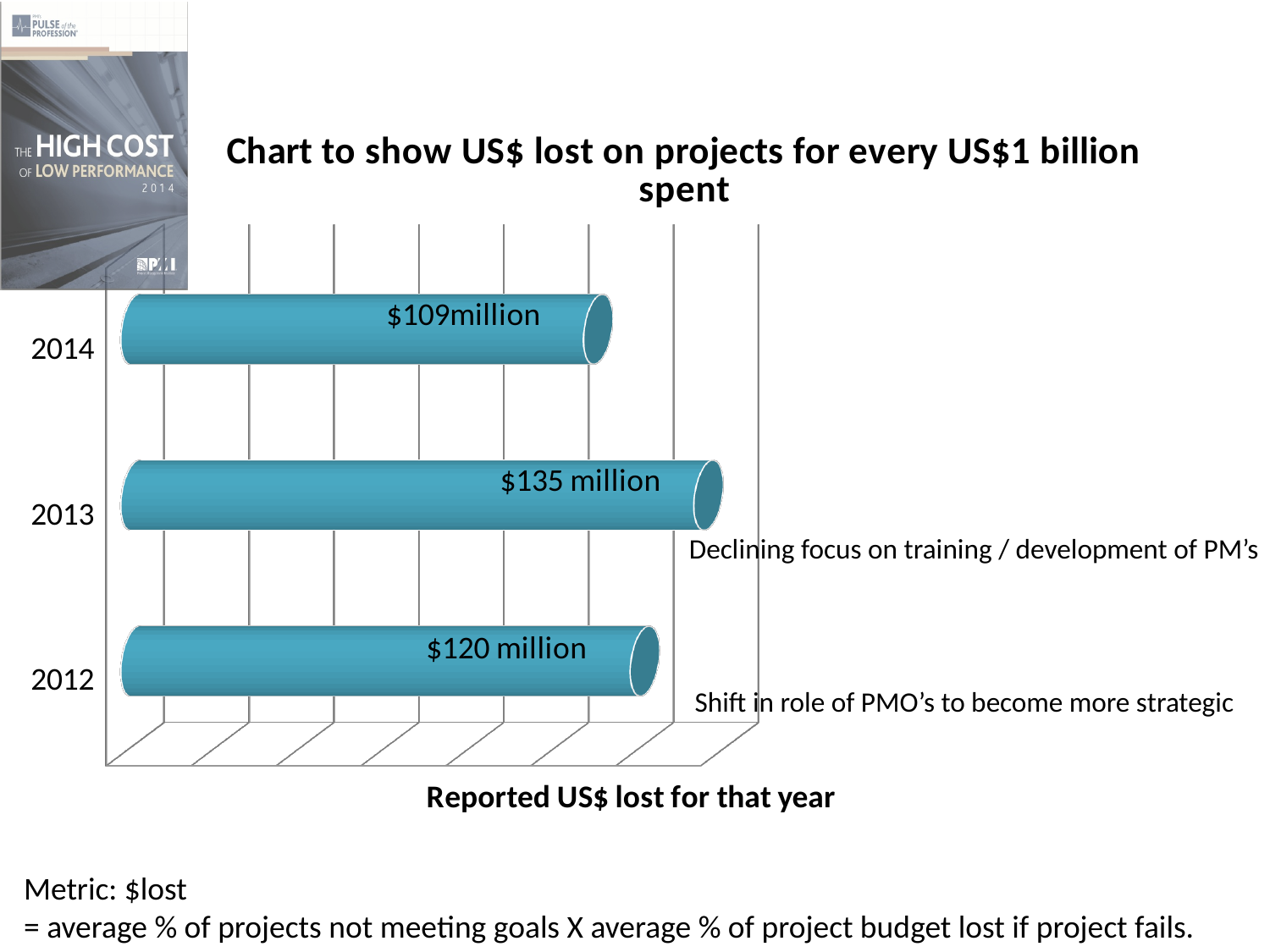
Which year has the lowest US$ lost? 2014 What is the value shown for 2014? $109million What kind of chart is shown on the slide? Bar chart What is the label shown below the chart's horizontal axis? Reported US$ lost for that year Did the US$ lost rise or fall from 2013 to 2014? Fall What is the difference between the values for 2013 and 2012? $15 million How many years are shown in the chart? 3 What is the difference between the values for 2013 and 2014? $26 million Which is larger, the value for 2012 or the value for 2014? 2012 Which year has the highest US$ lost? 2013 What is the value shown for 2012? $120 million What is the value shown for 2013? $135 million